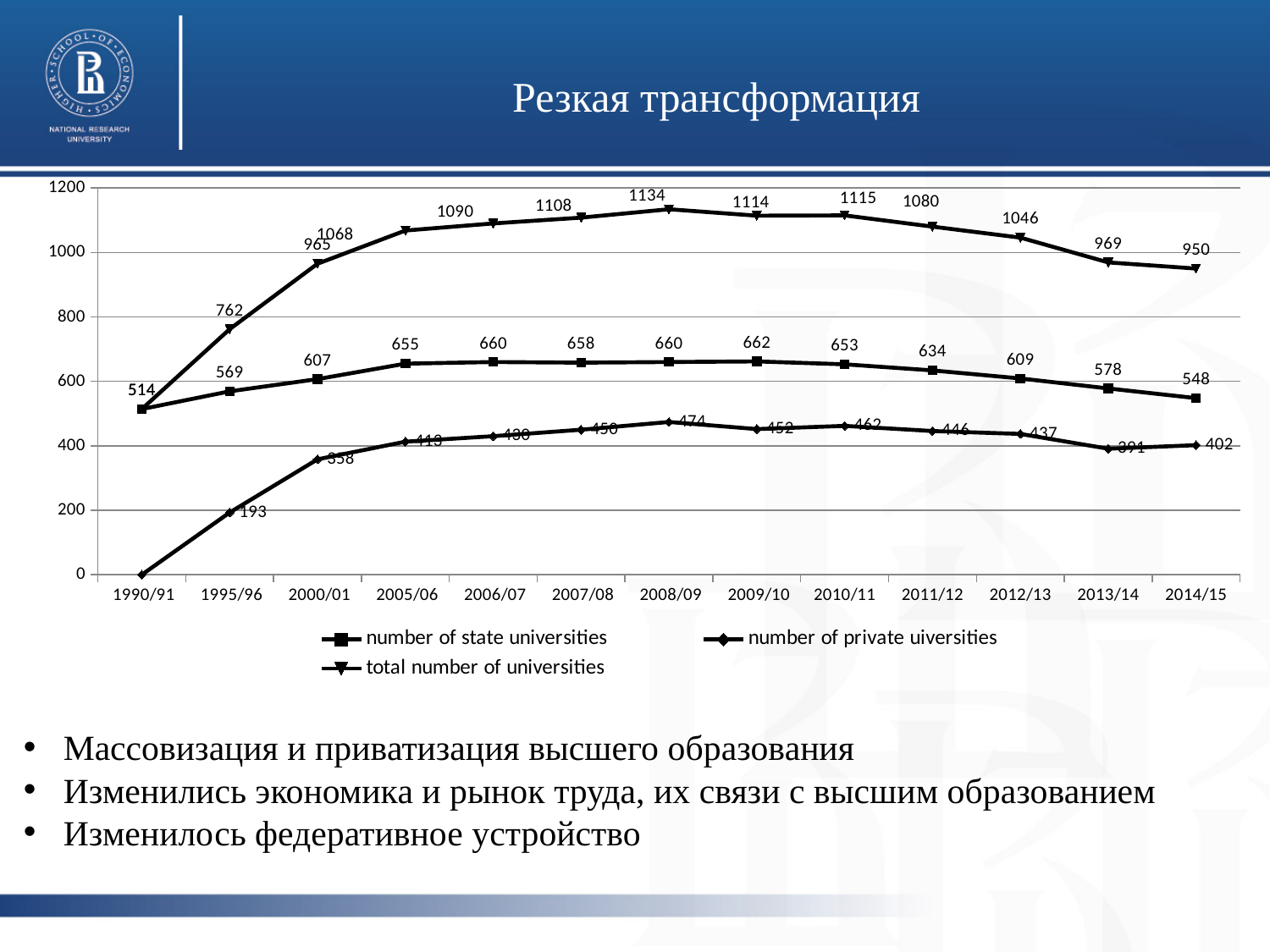
What is the number of private universities in 2013/14? 391 How many series does the legend list? 3 Which series is drawn with triangle markers? total number of universities What is the number of state universities in 2009/10? 662 How many academic years are shown on the x axis? 13 Which is larger: the number of private universities in 2010/11 or in 2011/12? 2010/11 What kind of chart is shown on the slide? line chart In which year is the number of state universities lowest? 1990/91 In which year is the total number of universities highest? 2008/09 What is the difference between the total number of universities in 2008/09 and in 2014/15? 184 Does the total number of universities rise or fall from 2010/11 to 2014/15? fall What is the total number of universities in 2008/09? 1134